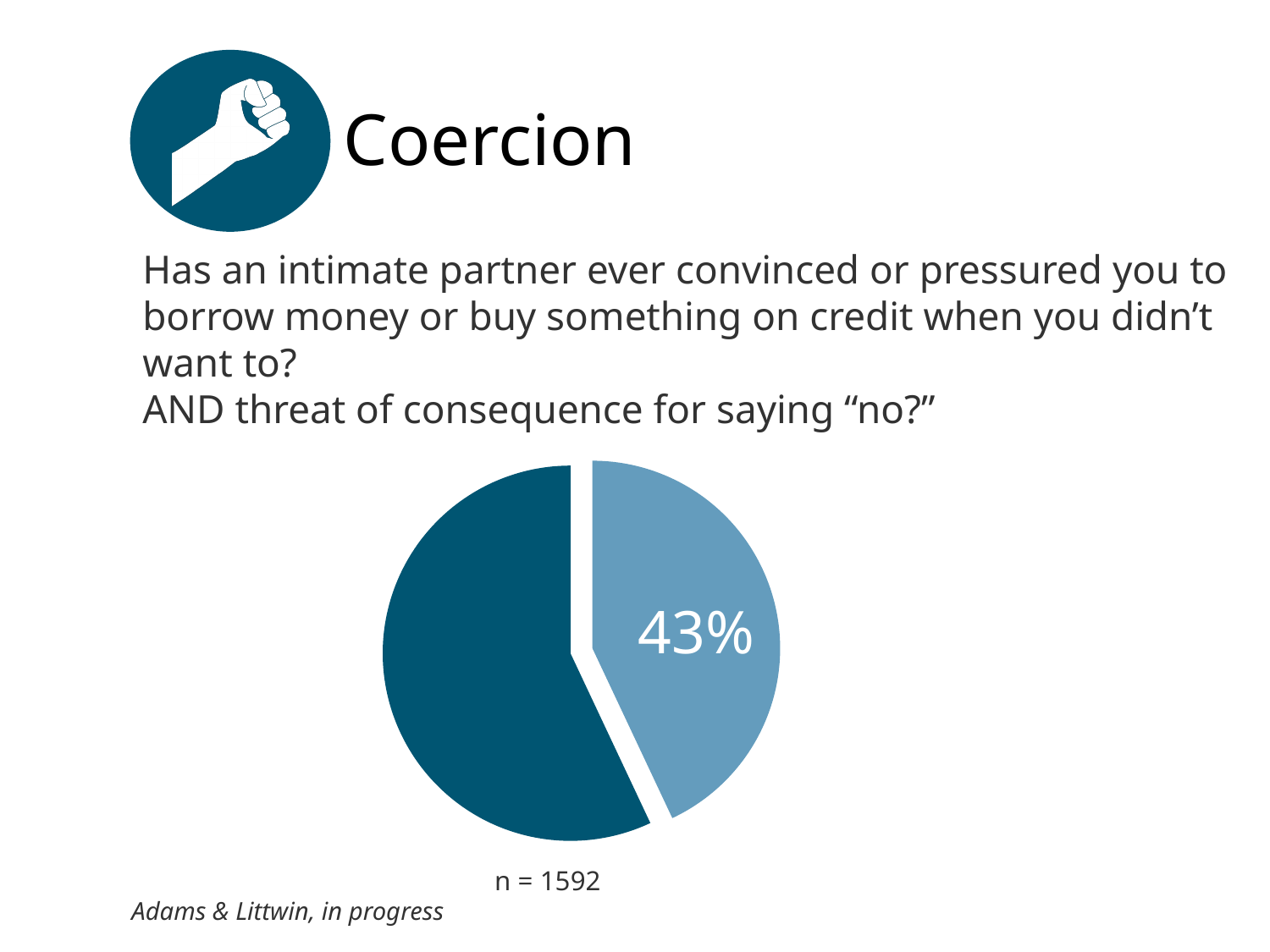
What share of the pie does the light blue slice represent? 43% What share of the pie does the dark blue slice represent, given the light blue slice is 43%? 57% What is the sample size (n) shown below the pie chart? n = 1592 Which slice of the pie chart is the largest? the dark blue slice Which slice of the pie chart is the smallest? the light blue slice (43%) How many slices does the pie chart have? 2 What percentage is printed on the light blue slice of the pie chart? 43% Which slice of the pie chart is larger, the light blue slice or the dark blue slice? the dark blue slice What kind of chart is shown on the slide? pie chart What is the title of the slide containing the pie chart? Coercion